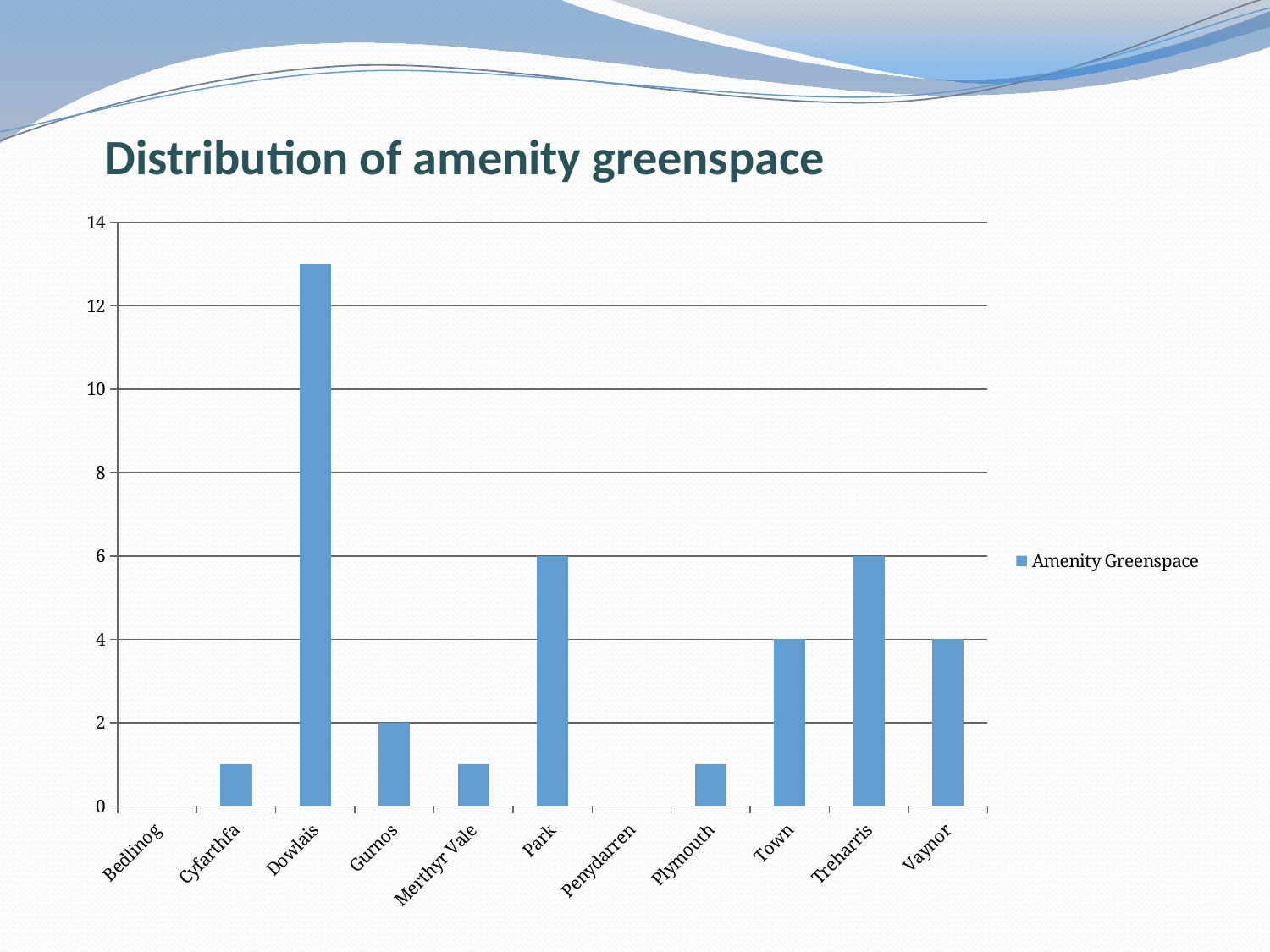
How many categories are shown on the x axis? 11 Which is larger, the value for Dowlais or the value for Treharris? Dowlais What is the title of the chart? Distribution of amenity greenspace What is the value for Vaynor? 4 What is the difference between the values for Park and Town? 2 What is the value for Gurnos? 2 Is the value for Cyfarthfa greater or less than 2? less Is the value for Dowlais greater or less than 12? greater Which category has the highest value? Dowlais What is the value for Town? 4 What is the value for Park? 6 What type of chart is shown on the slide? Bar chart